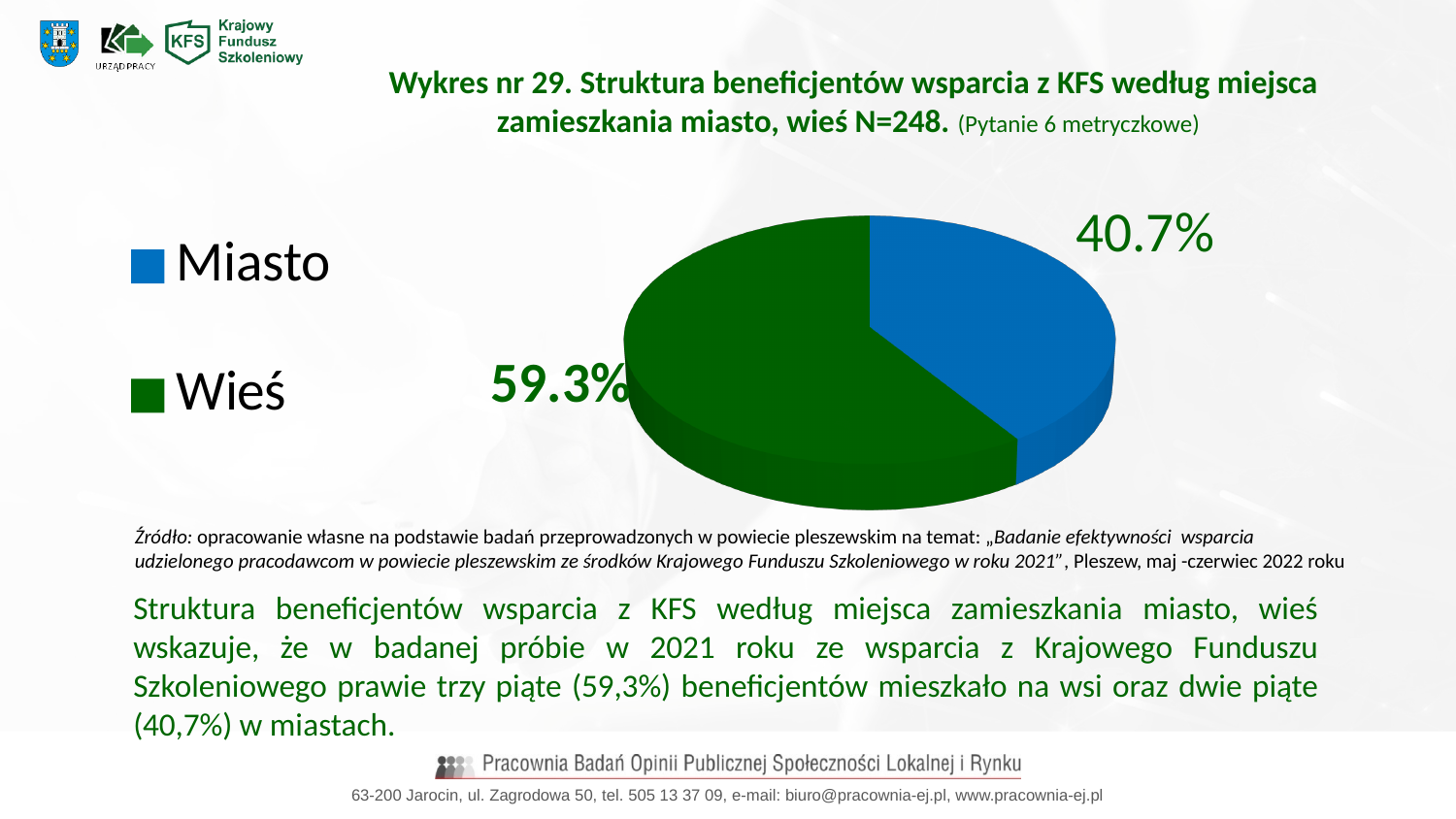
What is the difference in percentage points between the Wieś and Miasto shares? 18.6 Which category has the largest share in the pie chart? Wieś What is the sample size N stated in the chart title? 248 What share of the pie chart is labelled for Wieś? 59.3% How many categories does the pie chart show? 2 What share of the pie chart is labelled for Miasto? 40.7% Which category has the larger share of the pie, Miasto or Wieś? Wieś What kind of chart is shown on the slide? pie chart What colour represents Miasto in the pie chart? blue What colour represents Wieś in the pie chart? green Which category has the smallest share in the pie chart? Miasto